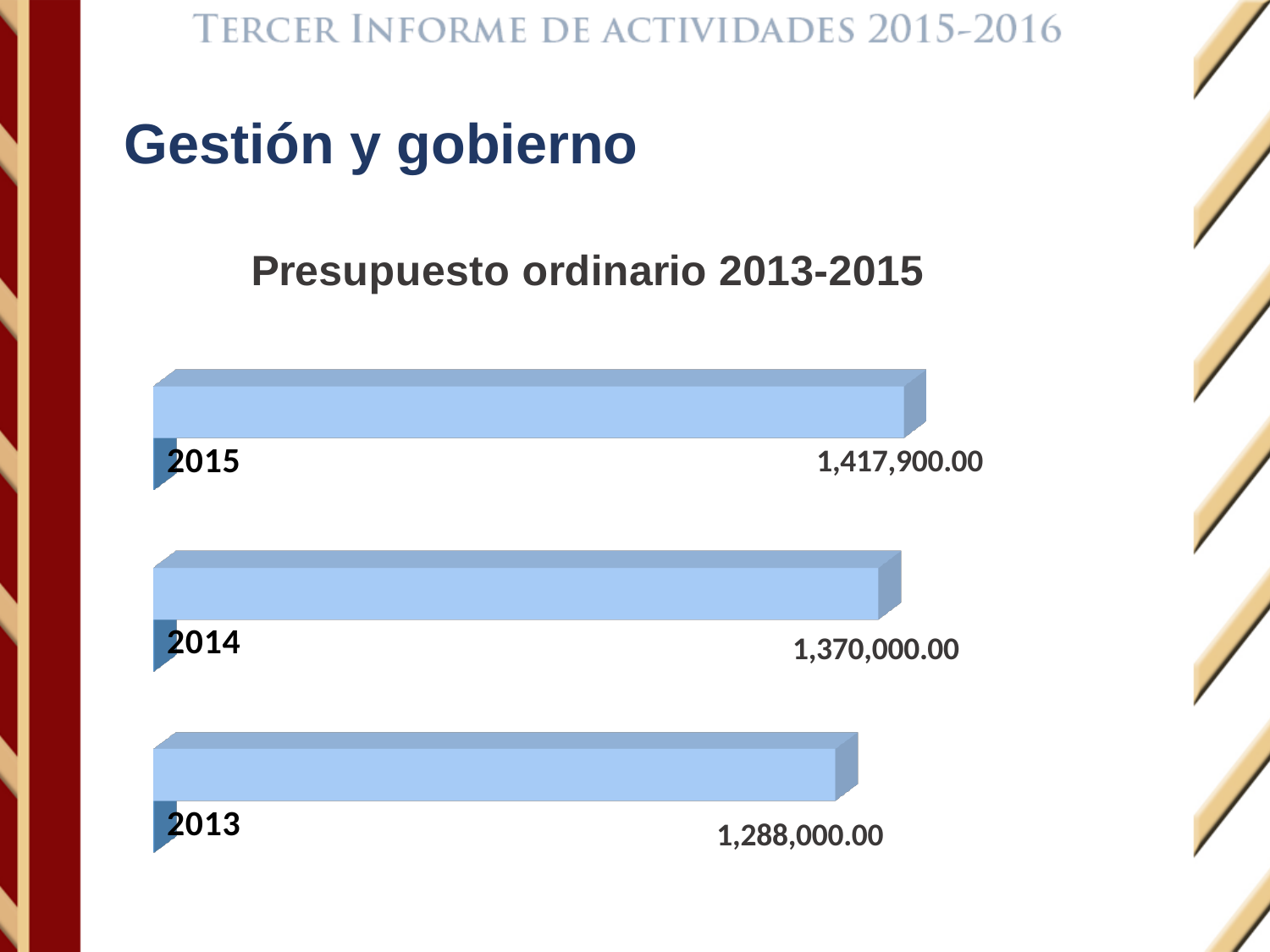
What is the difference between the values for 2015 and 2013? 129,900.00 What is the value for 2015? 1,417,900.00 What is the difference between the values for 2014 and 2013? 82,000.00 What kind of chart is shown? bar chart Which is larger, the value for 2014 or the value for 2013? 2014 Which year has the lowest value? 2013 Which year has the highest value? 2015 What is the difference between the values for 2015 and 2014? 47,900.00 What is the value for 2014? 1,370,000.00 How many years are shown in the chart? 3 What is the value for 2013? 1,288,000.00 What is the title of the chart? Presupuesto ordinario 2013-2015